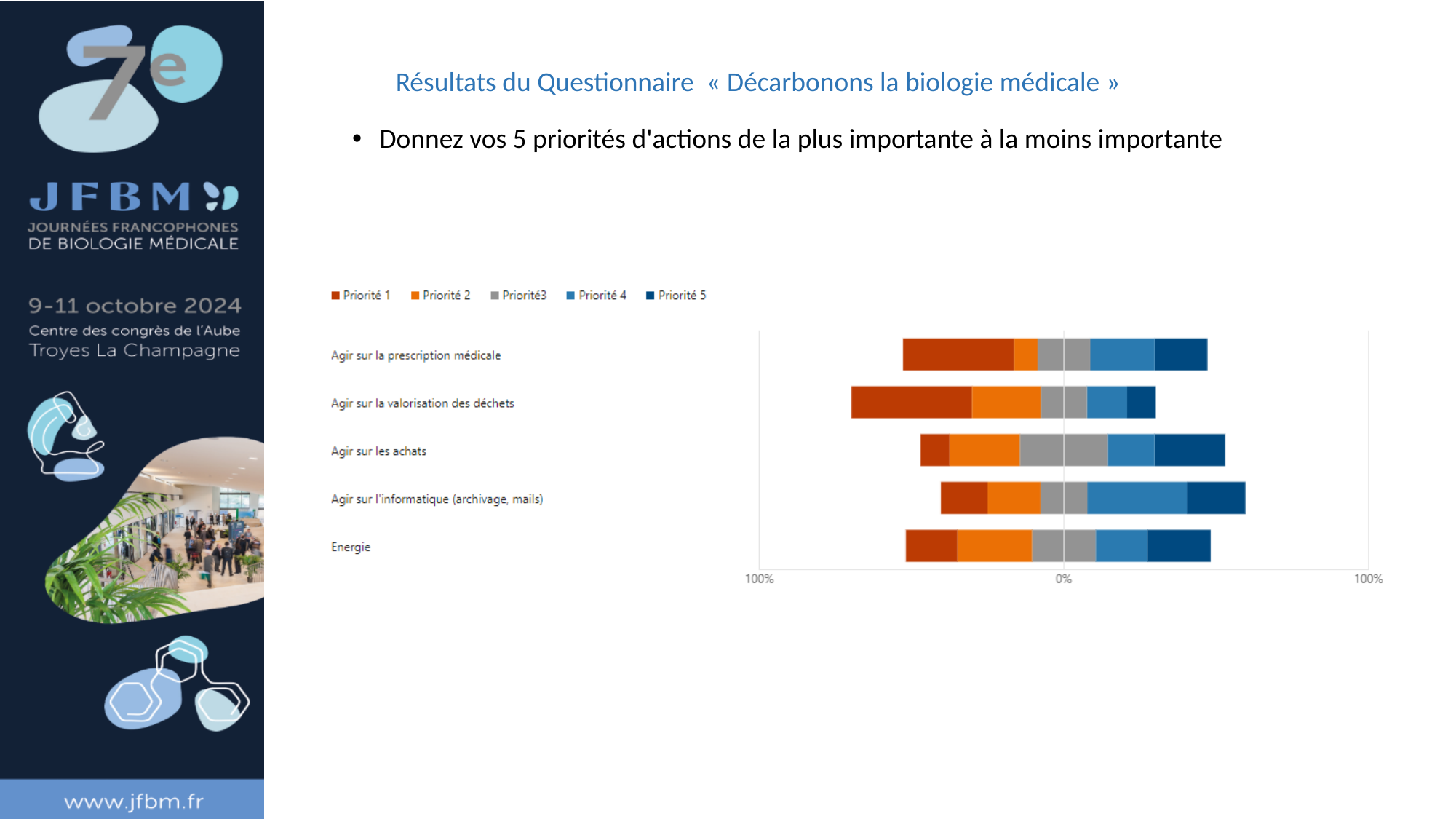
Which category has the shortest Priorité 2 segment? Agir sur la prescription médicale How many series does the chart legend list? 5 Which category has the shortest Priorité 5 segment? Agir sur la valorisation des déchets Which category has the shortest Priorité 1 segment? Agir sur les achats Which has the larger Priorité 2 segment: Agir sur la prescription médicale or Energie? Energie What kind of chart is shown on the slide? Stacked bar chart Which has the larger Priorité 1 segment: Agir sur la valorisation des déchets or Agir sur la prescription médicale? Agir sur la valorisation des déchets Which category has the longest Priorité 1 segment? Agir sur la valorisation des déchets Which category has the longest Priorité3 segment? Agir sur les achats How many action categories are plotted in the chart? 5 What are the series names listed in the chart legend? Priorité 1, Priorité 2, Priorité3, Priorité 4, Priorité 5 What label appears at the centre of the horizontal axis? 0%